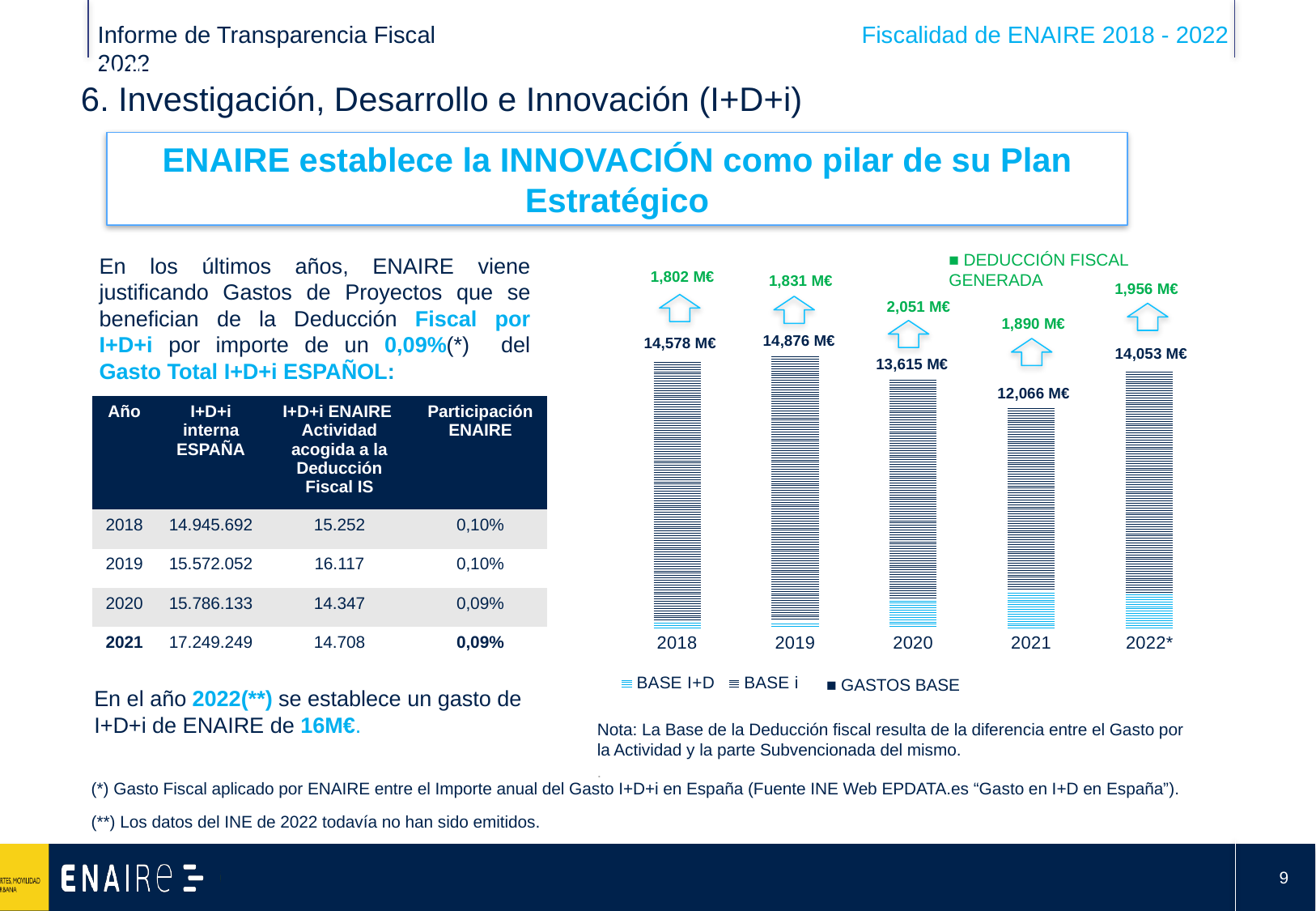
Which bar total is larger, 2018 or 2022*? 2018 What is the DEDUCCIÓN FISCAL GENERADA value shown for 2022*? 1,956 M€ What is the difference between the bar totals for 2019 and 2021? 2,810 M€ How many years are shown on the x axis of the chart? 5 Which year has the lowest bar total in the chart? 2021 Which year shows the lowest DEDUCCIÓN FISCAL GENERADA value? 2018 What kind of chart is shown on the right of the slide? Bar chart What is the value labelled above the bar for 2018? 14,578 M€ Which year has the highest bar total in the chart? 2019 What is the DEDUCCIÓN FISCAL GENERADA value shown for 2020? 2,051 M€ How many entries does the legend at the bottom of the chart list? 3 Which year shows the highest DEDUCCIÓN FISCAL GENERADA value? 2020